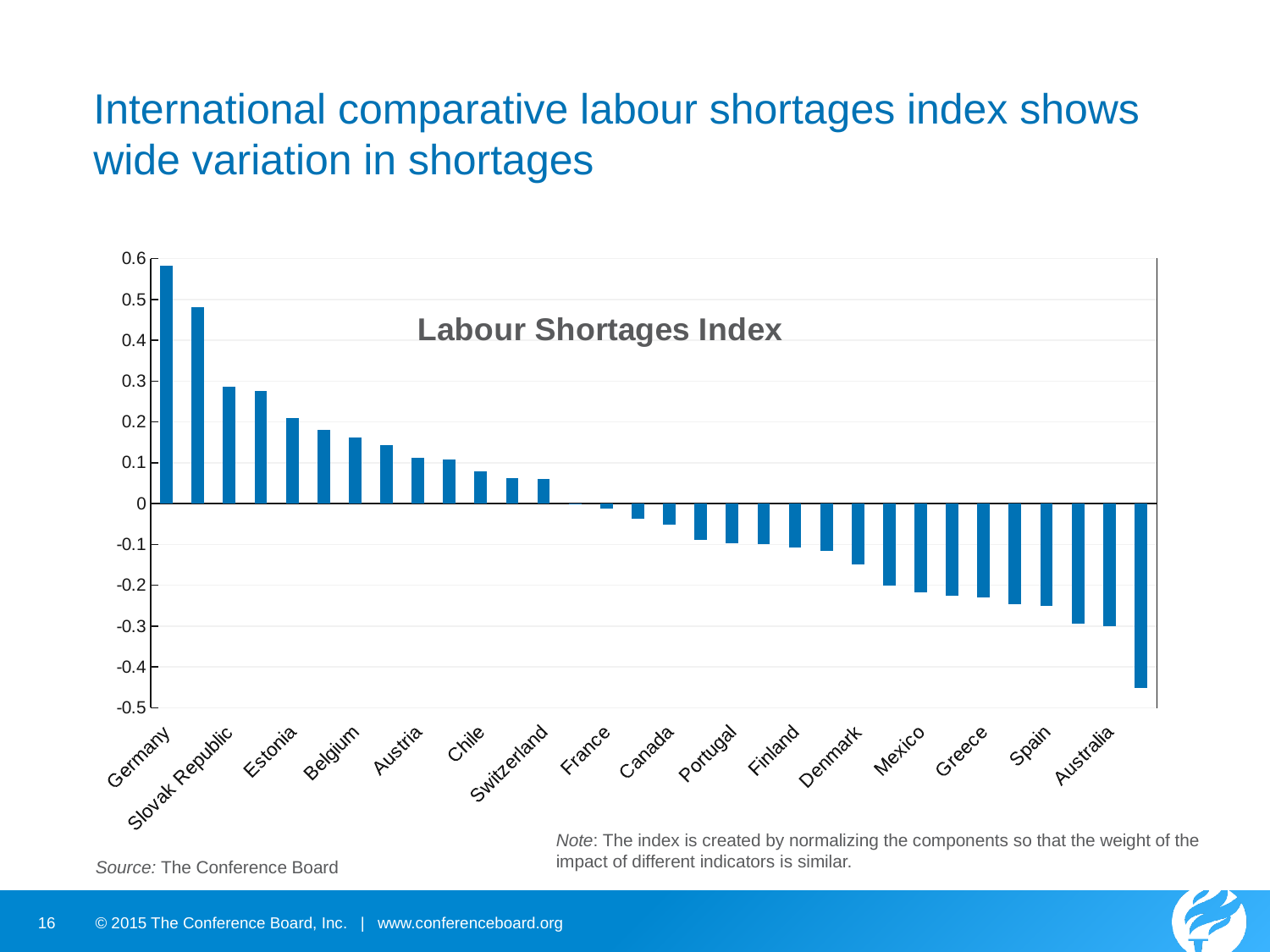
Do the values rise or fall moving from left to right along the x axis? fall Is the value for Greece greater or less than -0.2? less Which country has the highest value on the Labour Shortages Index? Germany Is the value for Switzerland greater or less than 0.1? less What kind of chart is shown on the slide? Bar chart Is the value for Belgium greater or less than 0.2? less Which has the larger value on the index, Germany or Australia? Germany What source is cited for the chart? The Conference Board What is the title printed inside the chart? Labour Shortages Index